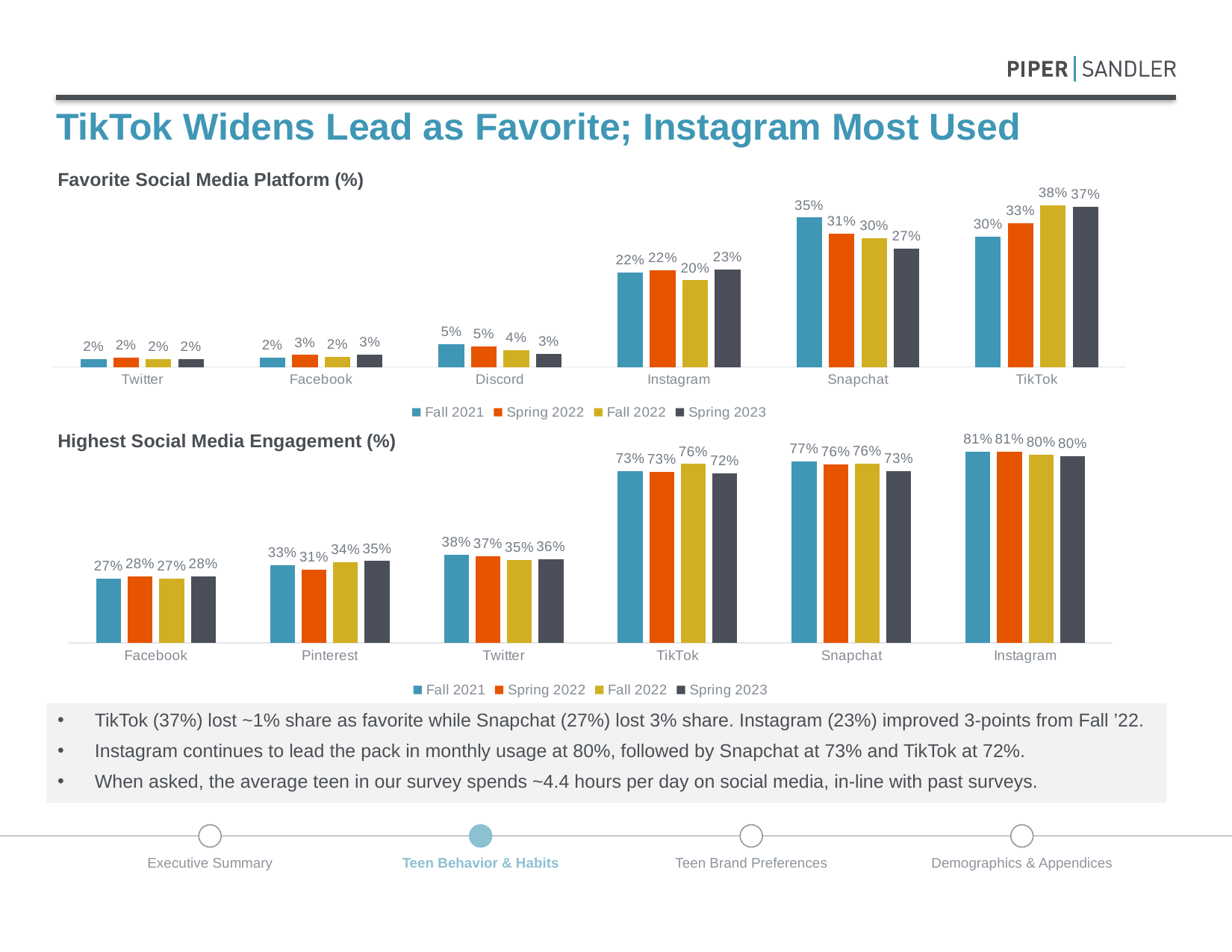
In the 'Highest Social Media Engagement (%)' chart, which is larger for Spring 2023: Snapchat or TikTok? Snapchat How many platforms are shown on the x axis of the 'Highest Social Media Engagement (%)' chart? 6 In the 'Favorite Social Media Platform (%)' chart, what is the difference between the Fall 2022 and Spring 2023 values for Instagram? 3% In the 'Highest Social Media Engagement (%)' chart, what is the Fall 2021 value for Twitter? 38% In the 'Favorite Social Media Platform (%)' chart, how many series does the legend list? 4 In the 'Favorite Social Media Platform (%)' chart, which platform has the highest Spring 2023 value? TikTok In the 'Highest Social Media Engagement (%)' chart, which platform has the lowest Spring 2023 value? Facebook In the 'Favorite Social Media Platform (%)' chart, what is the Fall 2021 value for Snapchat? 35% In the 'Favorite Social Media Platform (%)' chart, what is the Spring 2023 value for TikTok? 37% In the 'Highest Social Media Engagement (%)' chart, what is the difference between the Fall 2021 and Spring 2023 values for Snapchat? 4% What kind of chart is the 'Favorite Social Media Platform (%)' chart? Bar chart In the 'Highest Social Media Engagement (%)' chart, what is the Spring 2023 value for Instagram? 80%